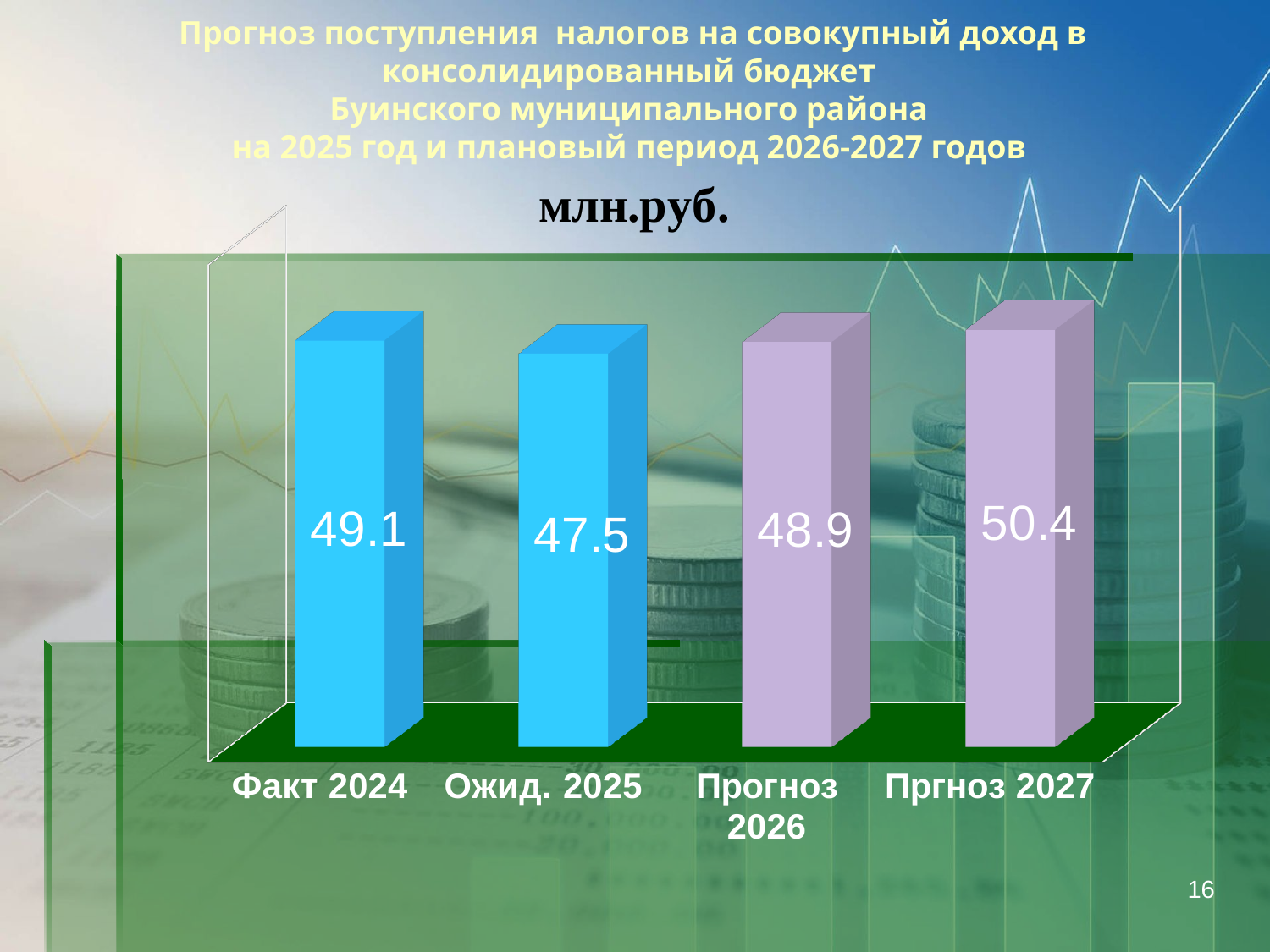
What kind of chart is shown on the slide? bar chart What is the value for Ожид. 2025? 47.5 What is the difference between the values for Пргноз 2027 and Ожид. 2025? 2.9 Which category has the highest value? Пргноз 2027 Which is larger, the value for Факт 2024 or the value for Ожид. 2025? Факт 2024 What is the value for Прогноз 2026? 48.9 What unit is given in the chart title? млн.руб. How many categories are shown in the chart? 4 What is the difference between the values for Факт 2024 and Прогноз 2026? 0.2 Which category has the lowest value? Ожид. 2025 What is the value for Факт 2024? 49.1 What is the value for Пргноз 2027? 50.4